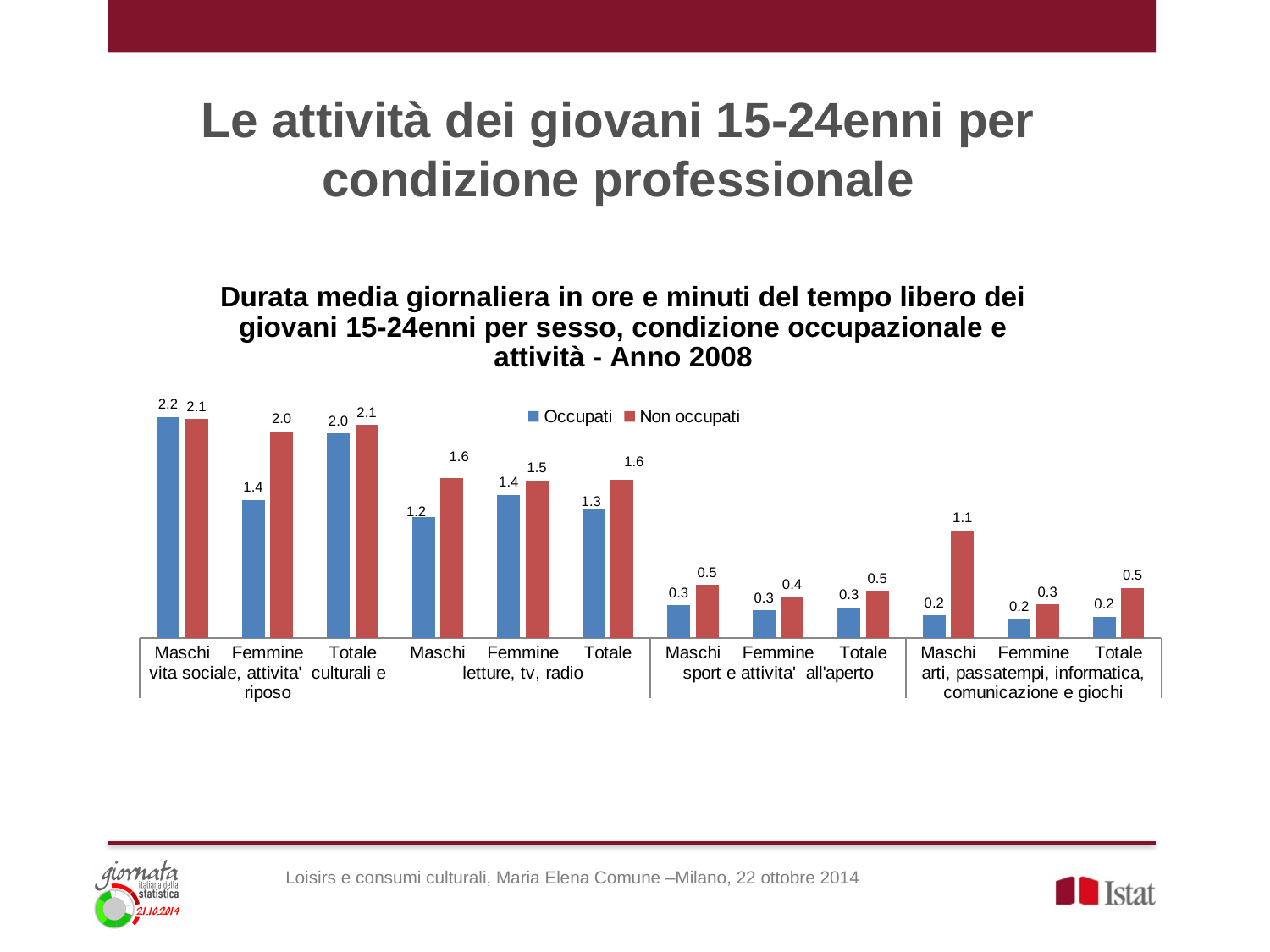
Which category has the highest Occupati value? Maschi, vita sociale, attivita' culturali e riposo What is the Non occupati value for Femmine in the 'letture, tv, radio' group? 1.5 What is the Non occupati value for Maschi in the 'arti, passatempi, informatica, comunicazione e giochi' group? 1.1 What is the difference between the Non occupati and Occupati values for Femmine in the 'vita sociale, attivita' culturali e riposo' group? 0.6 What is the difference between the Non occupati and Occupati values for Maschi in the 'arti, passatempi, informatica, comunicazione e giochi' group? 0.9 What is the Occupati value for Maschi in the 'vita sociale, attivita' culturali e riposo' group? 2.2 What is the Occupati value for Totale in the 'sport e attivita' all'aperto' group? 0.3 For Totale in the 'letture, tv, radio' group, which is larger: Occupati or Non occupati? Non occupati Which colour represents the Non occupati series? Red What kind of chart is shown on the slide? Bar chart How many categories (bar groups) are shown on the x axis? 12 How many series does the legend list? 2